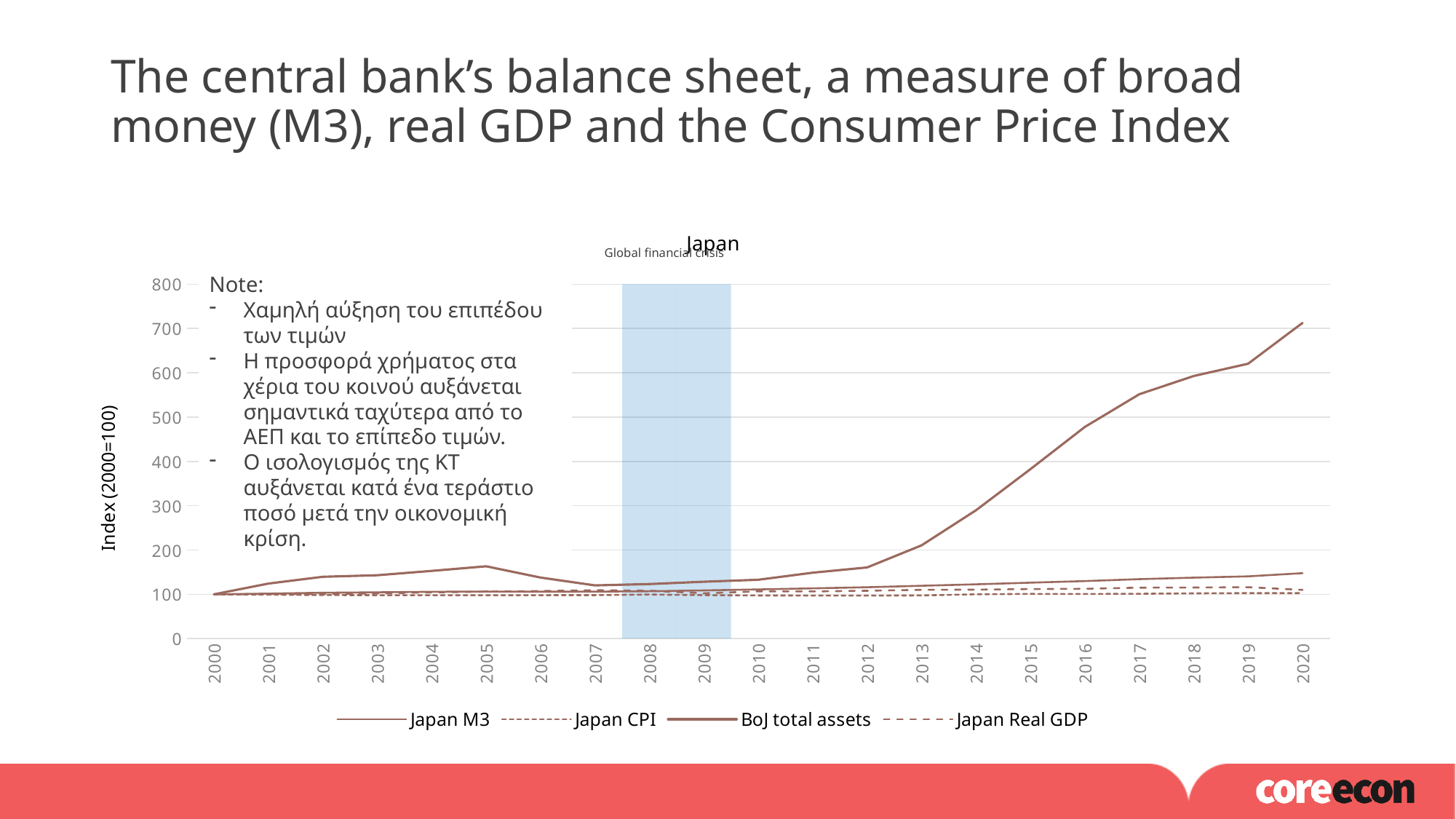
What event does the shaded region on the chart mark? Global financial crisis What is the index value of all four series in 2000? 100 Is the value of BoJ total assets in 2012 greater or less than 200? less Is the value of Japan M3 in 2020 greater or less than 200? less What kind of chart is shown on the slide? line chart Is the value of BoJ total assets in 2020 greater or less than 600? greater How many series does the chart legend list? 4 Which is larger in 2020, BoJ total assets or Japan M3? BoJ total assets How many years are shown along the x axis of the chart? 21 Does the BoJ total assets series rise or fall between 2012 and 2020? rise Which series has the highest value in 2020? BoJ total assets